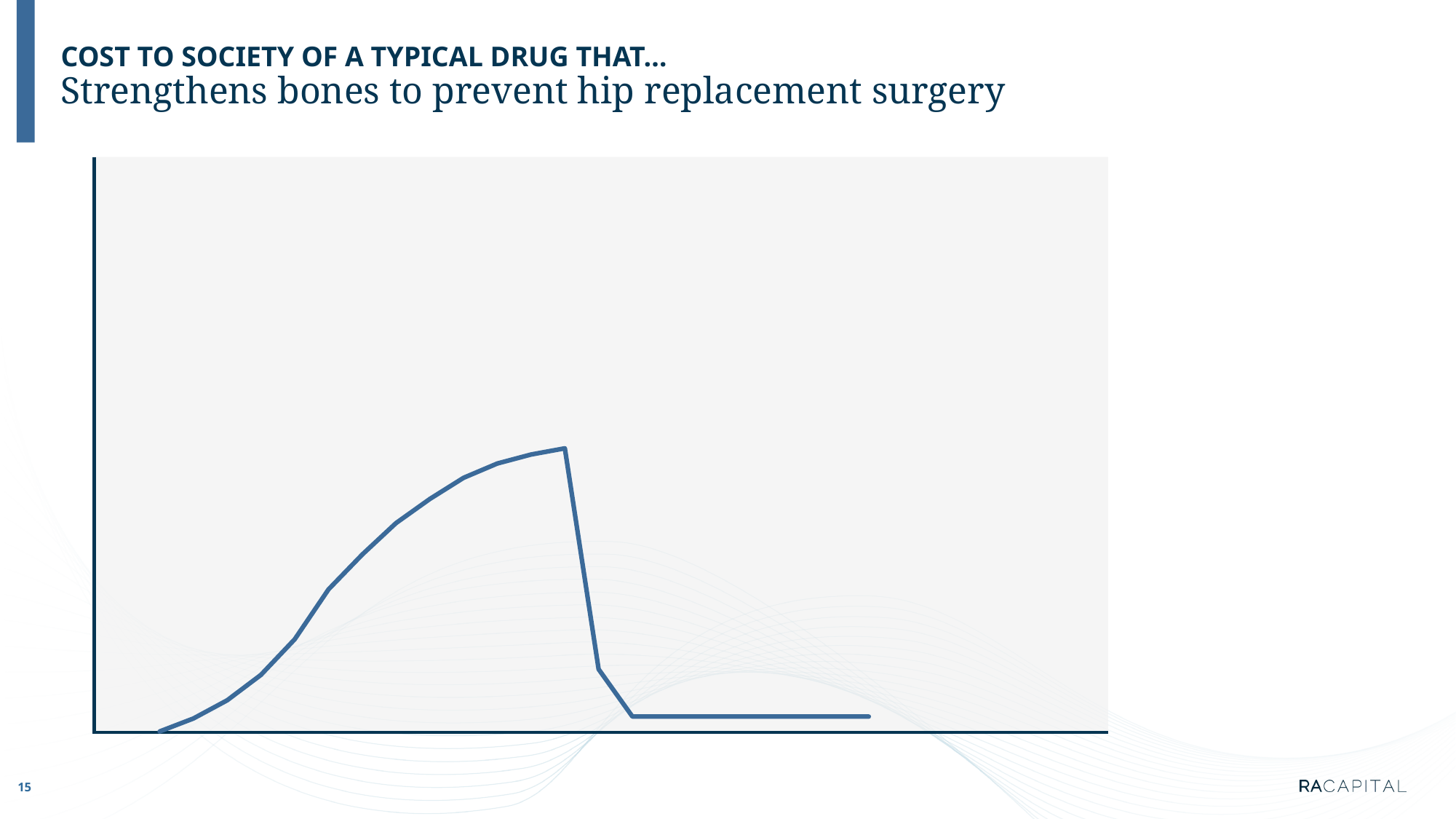
After its sharp drop, does the plotted line rise, fall, or stay flat along the rest of the x axis? Stay flat Does the plotted line rise or fall over the left portion of the x axis, before its peak? Rise How many lines are plotted on the chart? 1 What is the heading text above the chart that describes what the drug does? Strengthens bones to prevent hip replacement surgery What kind of chart is shown on the slide? Line chart Immediately after reaching its peak, does the plotted line rise or fall? Fall